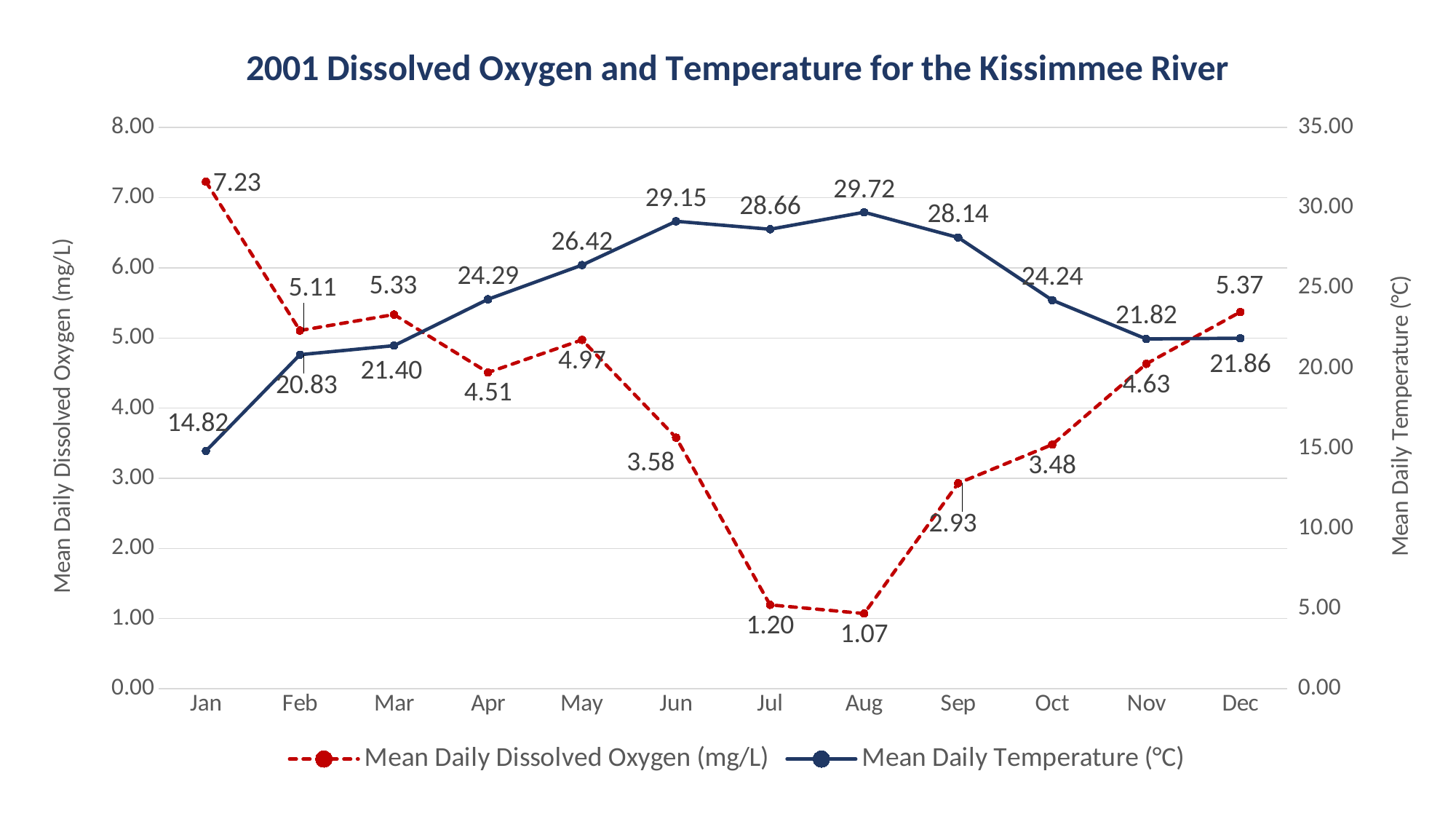
Which month has the lowest Mean Daily Temperature (°C)? Jan Which month has the higher Mean Daily Temperature (°C), Jun or Sep? Jun Does the Mean Daily Temperature (°C) rise or fall from Jan to Aug? Rise How many series does the legend list? 2 Which month has the highest Mean Daily Temperature (°C)? Aug What is the Mean Daily Temperature (°C) value for Aug? 29.72 What is the Mean Daily Dissolved Oxygen (mg/L) value for Oct? 3.48 What kind of chart is shown on the slide? Line chart What is the Mean Daily Dissolved Oxygen (mg/L) value for Jan? 7.23 How many months are plotted on the x axis? 12 What is the difference between the Mean Daily Dissolved Oxygen (mg/L) values for Jan and Aug? 6.16 Which month has the lowest Mean Daily Dissolved Oxygen (mg/L)? Aug